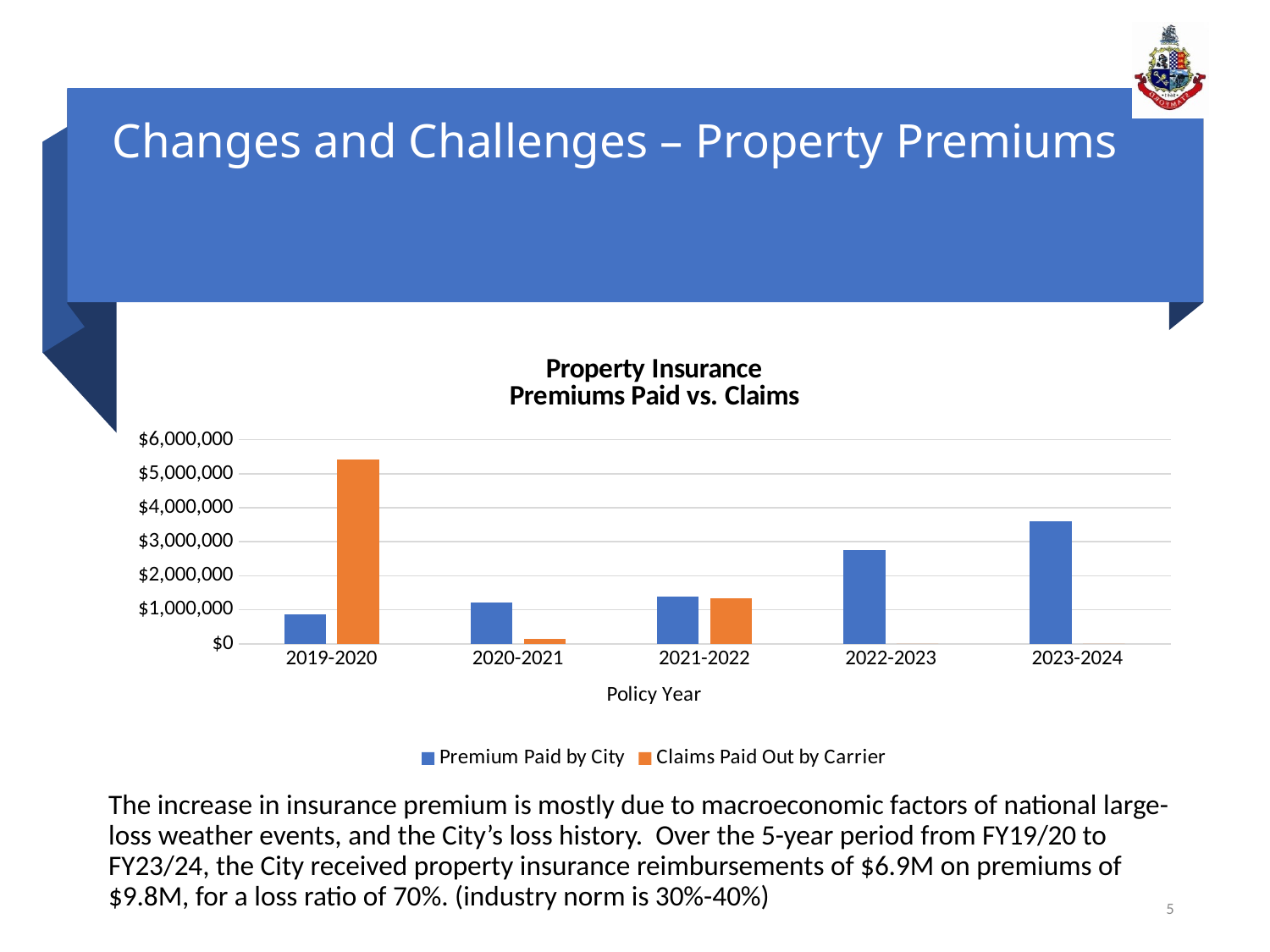
Which policy year has the lowest Premium Paid by City? 2019-2020 In 2019-2020, which is larger: Premium Paid by City or Claims Paid Out by Carrier? Claims Paid Out by Carrier Which policy year has the highest Premium Paid by City? 2023-2024 What kind of chart is shown on the slide? Bar chart Is the value for Premium Paid by City in 2023-2024 greater or less than $3,000,000? greater How many policy years are shown on the x axis? 5 Is the value for Premium Paid by City in 2019-2020 greater or less than $1,000,000? less Which policy year has the highest Claims Paid Out by Carrier? 2019-2020 What is the title of the x axis? Policy Year How many series does the legend list? 2 Does the Premium Paid by City rise or fall across the policy years from 2019-2020 to 2023-2024? Rise Is the value for Claims Paid Out by Carrier in 2019-2020 greater or less than $5,000,000? greater